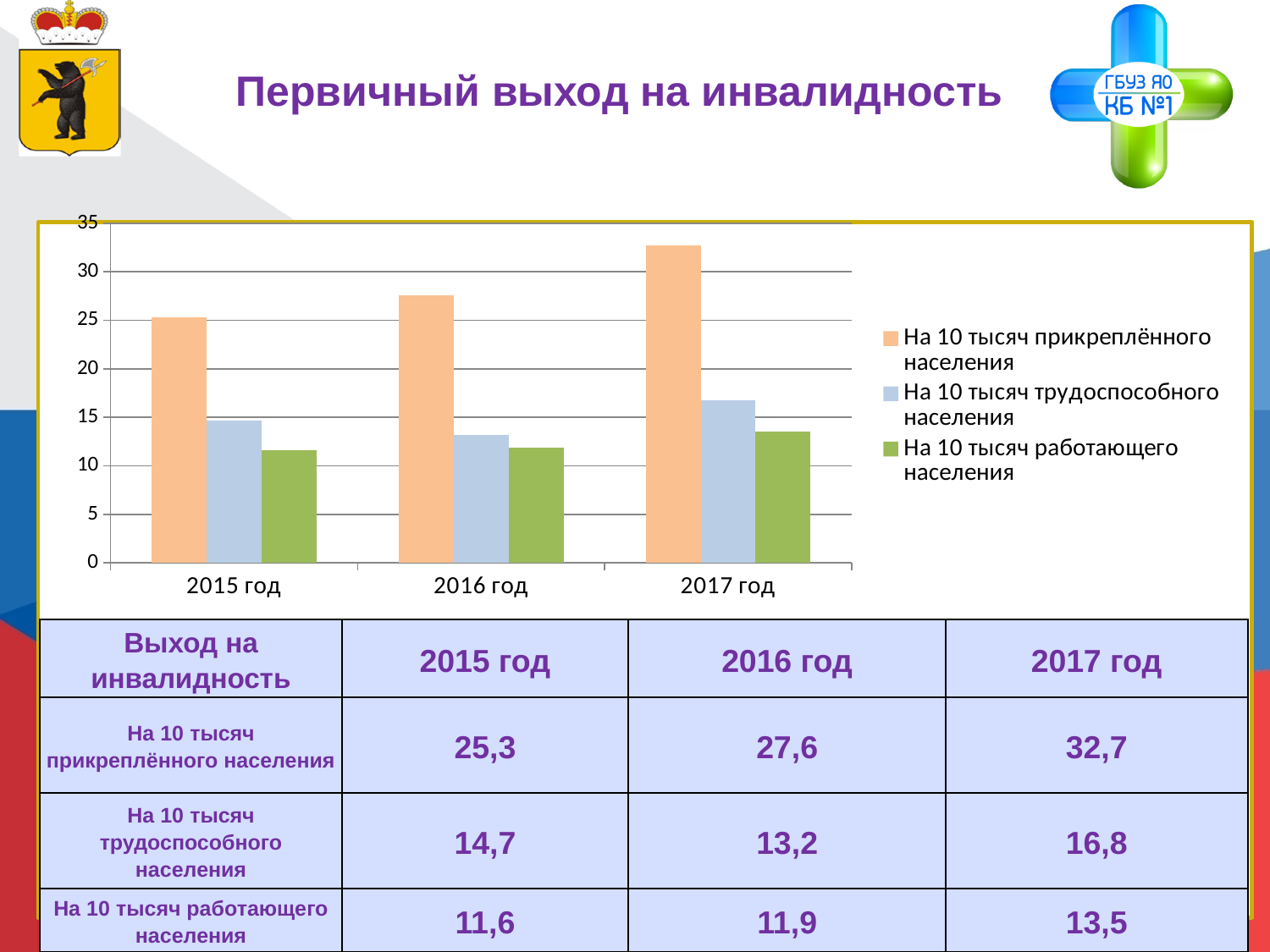
How many year categories are shown on the x axis of the chart? 3 Do the values for 'На 10 тысяч прикреплённого населения' rise or fall from 2015 год to 2017 год? rise What is the difference between the 2017 год and 2015 год values for 'На 10 тысяч прикреплённого населения'? 7,4 What is the value for 'На 10 тысяч трудоспособного населения' in 2016 год? 13,2 In which year is the value for 'На 10 тысяч прикреплённого населения' highest? 2017 год In which year is the value for 'На 10 тысяч трудоспособного населения' lowest? 2016 год What type of chart is shown on the slide? bar chart Which is larger in 2016 год: 'На 10 тысяч трудоспособного населения' or 'На 10 тысяч работающего населения'? На 10 тысяч трудоспособного населения What is the value for 'На 10 тысяч прикреплённого населения' in 2017 год? 32,7 What is the value for 'На 10 тысяч работающего населения' in 2015 год? 11,6 Is the value for 'На 10 тысяч прикреплённого населения' in 2017 год greater or less than 30? greater How many series does the chart legend list? 3